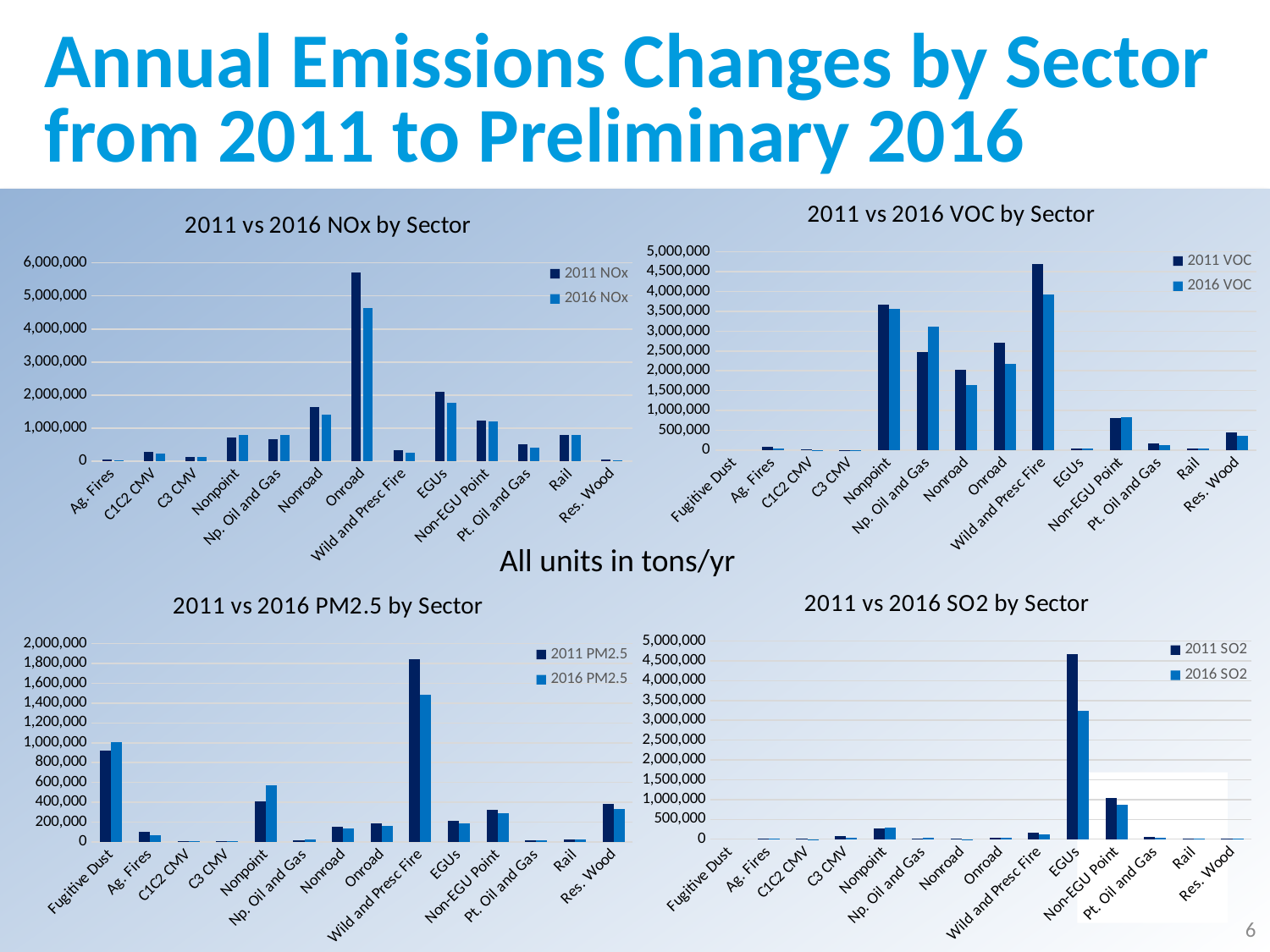
In the '2011 vs 2016 SO2 by Sector' chart, is the 2016 SO2 value for EGUs greater or less than 3,500,000? less In the '2011 vs 2016 NOx by Sector' chart, is the 2011 NOx value for Onroad greater or less than 5,000,000? greater In the '2011 vs 2016 VOC by Sector' chart, is the 2011 VOC value for Wild and Presc Fire greater or less than 4,000,000? greater What kind of chart is the '2011 vs 2016 NOx by Sector' chart? Bar chart In the '2011 vs 2016 VOC by Sector' chart, for Np. Oil and Gas, which is larger: the 2011 VOC value or the 2016 VOC value? 2016 VOC How many sectors are shown on the x axis of the '2011 vs 2016 PM2.5 by Sector' chart? 14 In the '2011 vs 2016 NOx by Sector' chart, which sector has the highest NOx emissions? Onroad In the '2011 vs 2016 VOC by Sector' chart, which sector has the highest 2011 VOC emissions? Wild and Presc Fire How many series does the legend of the '2011 vs 2016 VOC by Sector' chart list? 2 In the '2011 vs 2016 SO2 by Sector' chart, which sector has the highest SO2 emissions? EGUs